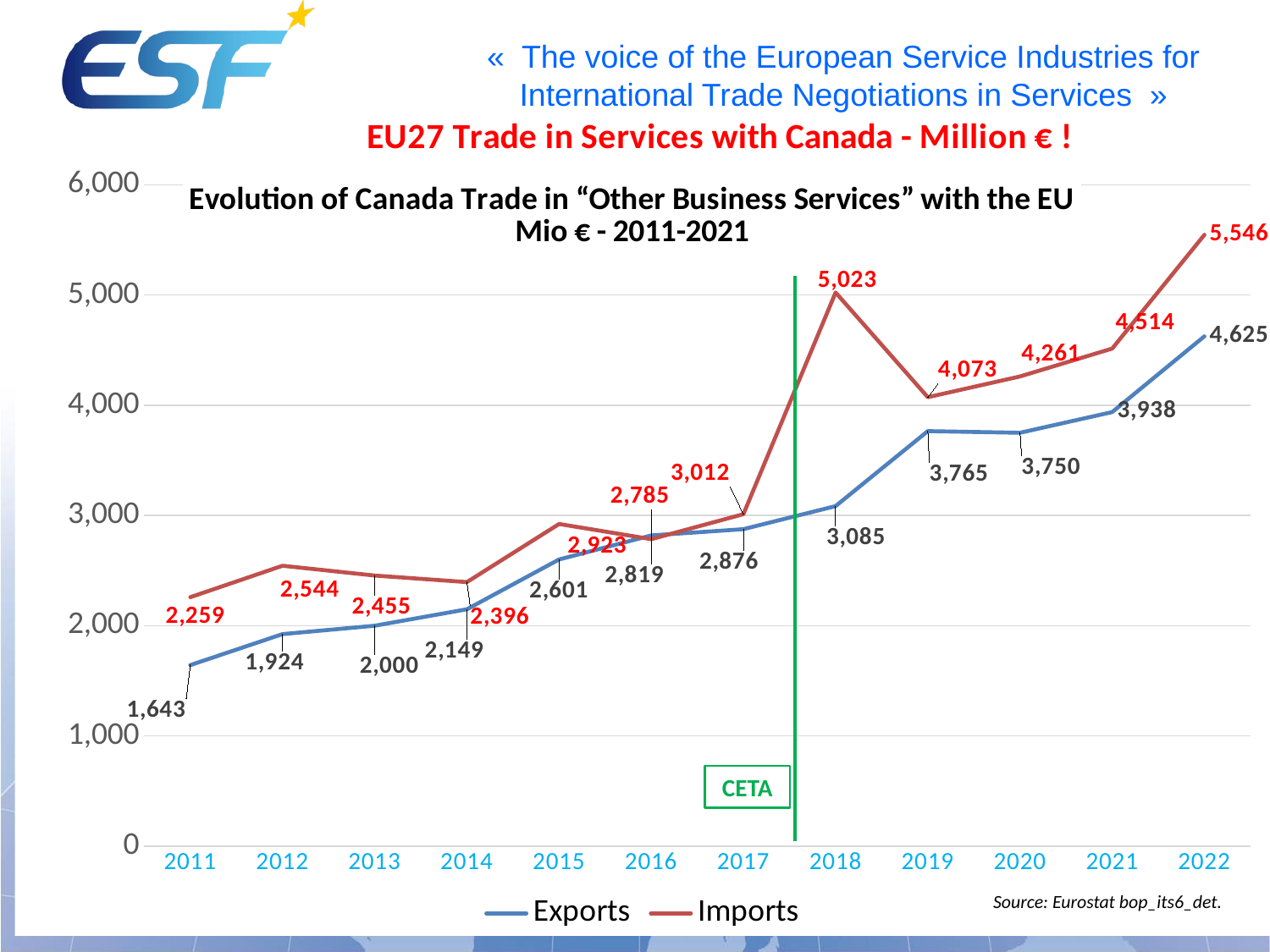
What label is shown in the green box next to the vertical green line? CETA What is the difference between Imports and Exports in 2022? 921 What is the value of Imports in 2018? 5,023 How many years are plotted along the x axis? 12 What is the value of Exports in 2011? 1,643 What type of chart is shown on the slide? Line chart What is the value of Exports in 2020? 3,750 Which is larger in 2013, Exports or Imports? Imports In which year are Imports highest? 2022 How many series does the legend list? 2 In which year are Exports lowest? 2011 Do Exports generally rise or fall from 2011 to 2022? Rise